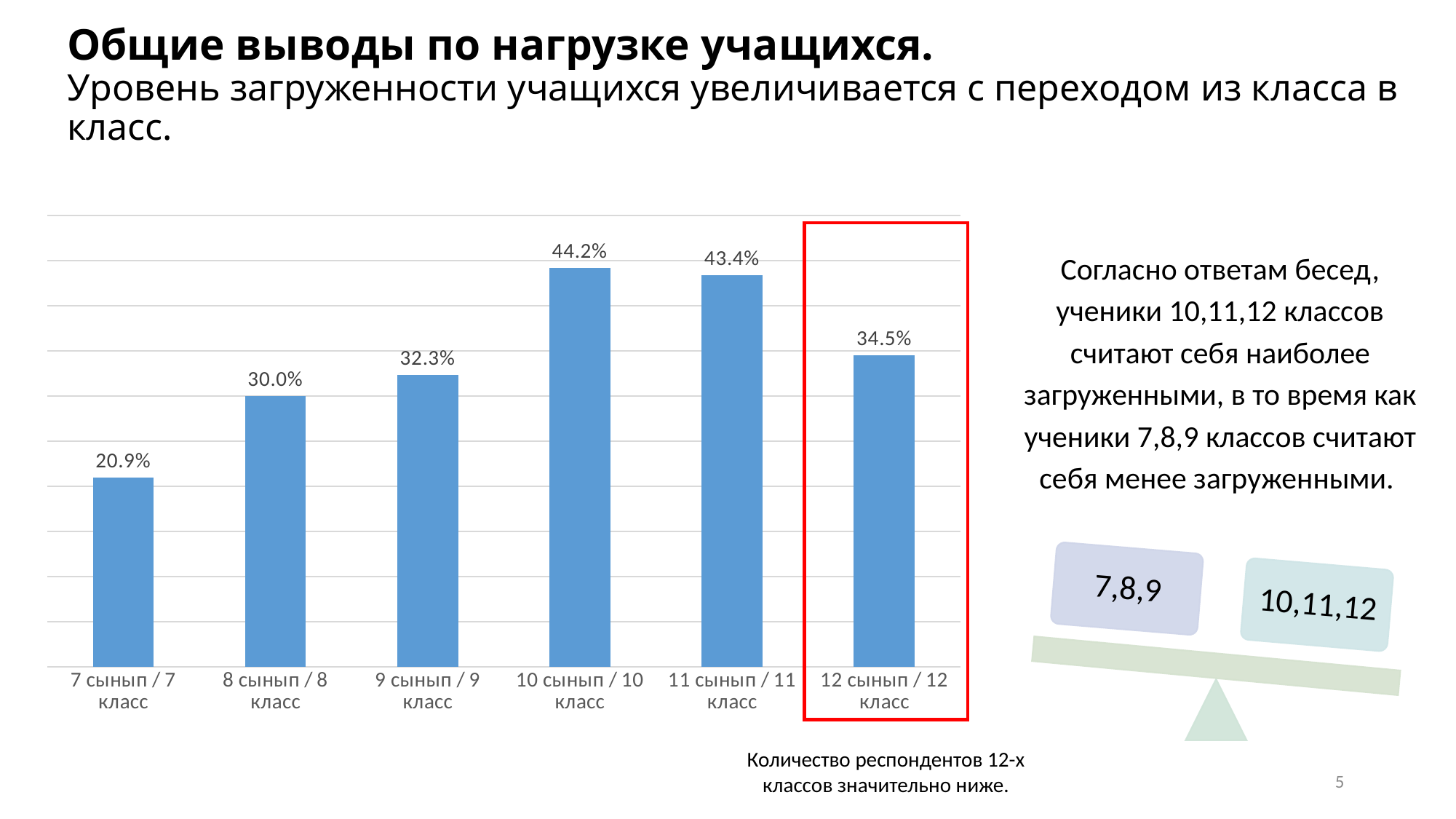
What is the value for 12 сынып / 12 класс? 34.5% What kind of chart is shown on the slide? bar chart Which category is outlined with a red box on the chart? 12 сынып / 12 класс What is the value for 7 сынып / 7 класс? 20.9% What is the value for 10 сынып / 10 класс? 44.2% Which category has the highest value? 10 сынып / 10 класс Which is larger, the value for 8 сынып / 8 класс or the value for 12 сынып / 12 класс? 12 сынып / 12 класс What is the difference between the values for 10 сынып / 10 класс and 7 сынып / 7 класс? 23.3% What is the difference between the values for 11 сынып / 11 класс and 12 сынып / 12 класс? 8.9% How many categories are shown on the x axis? 6 Which category has the lowest value? 7 сынып / 7 класс What is the value for 9 сынып / 9 класс? 32.3%